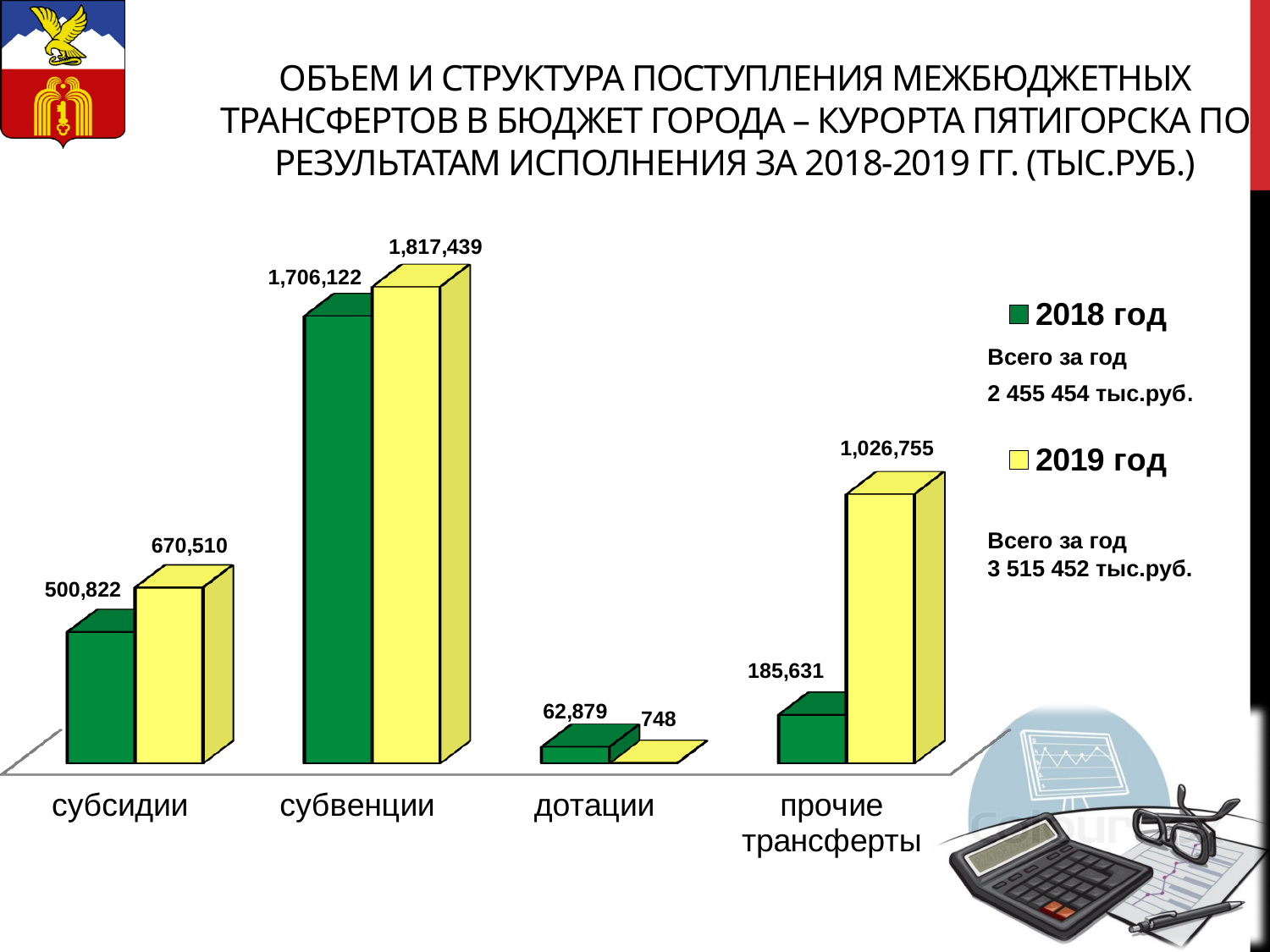
Which category has the highest value in 2019 год? субвенции Which is larger for дотации: the 2018 год value or the 2019 год value? 2018 год What is the value for дотации in 2019 год? 748 What is the value for субвенции in 2018 год? 1,706,122 How many categories are shown on the x axis? 4 What is the difference between the 2019 год and 2018 год values for субсидии? 169,688 Which category has the lowest value in 2018 год? дотации What is the value for субсидии in 2018 год? 500,822 What kind of chart is shown on the slide? bar chart What is the difference between the 2019 год and 2018 год values for прочие трансферты? 841,124 What is the value for прочие трансферты in 2019 год? 1,026,755 How many series does the legend list? 2